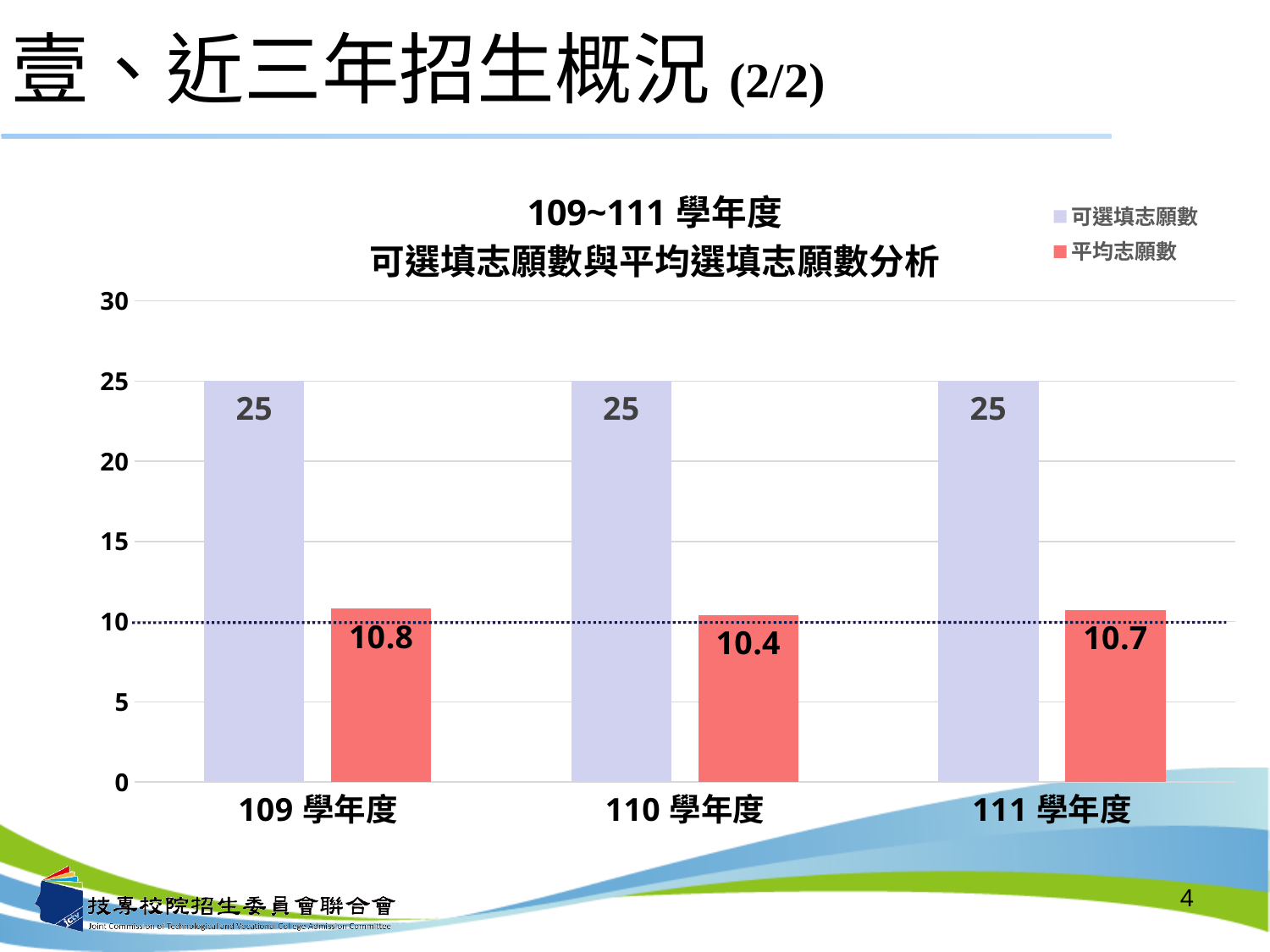
Which academic year has the highest 平均志願數? 109 學年度 What is the value of 平均志願數 for 109 學年度? 10.8 What is the value of 可選填志願數 for 111 學年度? 25 Is the 平均志願數 for 110 學年度 larger or smaller than that for 111 學年度? smaller Which academic year has the lowest 平均志願數? 110 學年度 What kind of chart is shown on the slide? bar chart How many series does the legend list? 2 What is the value of 平均志願數 for 110 學年度? 10.4 What is the difference in 平均志願數 between 109 學年度 and 110 學年度? 0.4 Which series is shown in red in the legend? 平均志願數 How many academic years are shown on the x axis? 3 What is the difference between 可選填志願數 and 平均志願數 for 111 學年度? 14.3